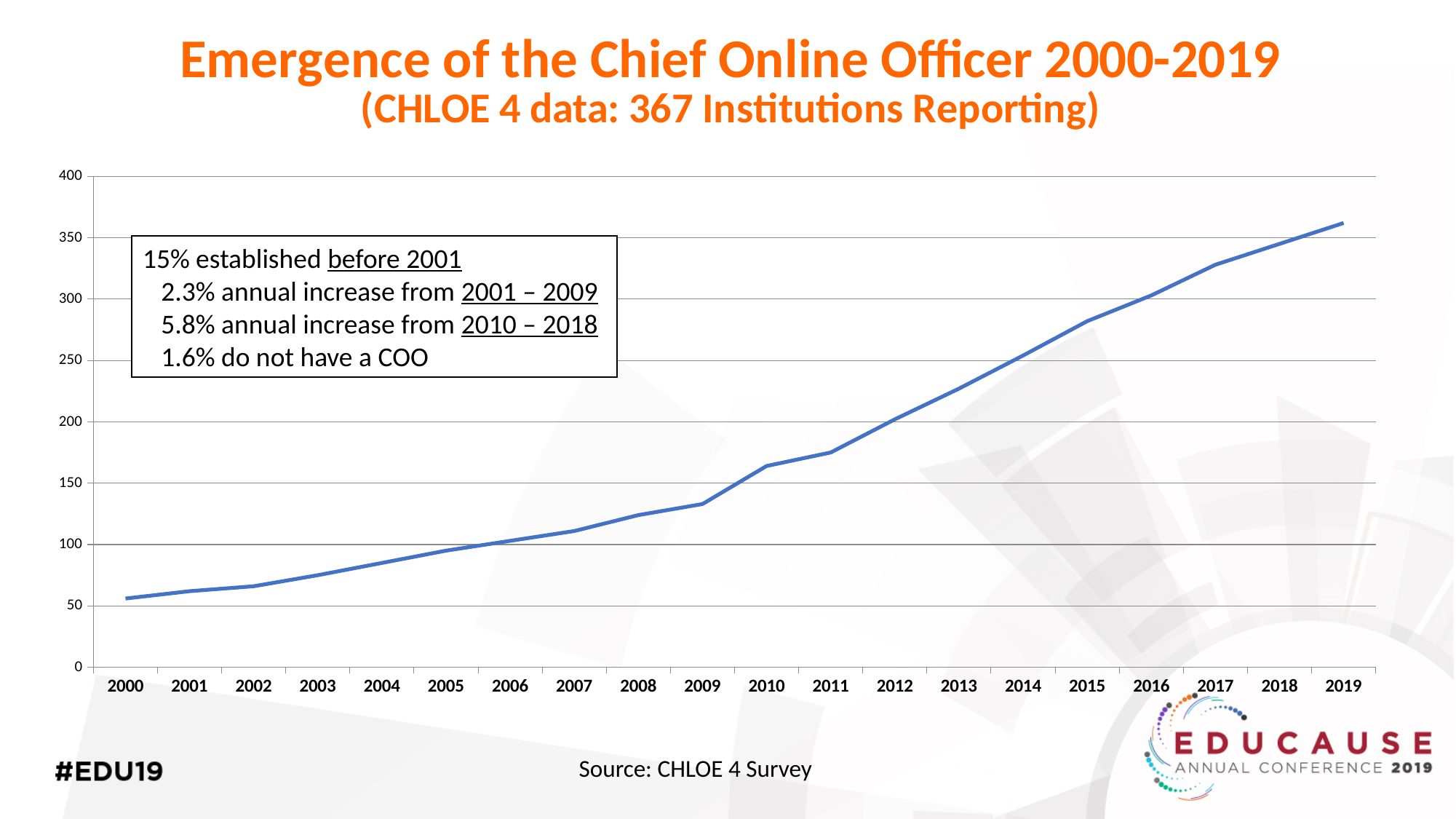
How many years are plotted along the x axis of the chart? 20 Which year has the larger value, 2009 or 2013? 2013 Is the value for 2010 greater or less than 150? greater Which year has the lowest value in the chart? 2000 Is the value for 2019 greater or less than 350? greater Which year has the highest value in the chart? 2019 Do the values in the chart rise or fall from 2000 to 2019? rise What kind of chart is shown on the slide? line chart Is the value for 2000 greater or less than 100? less What is the title of the chart on the slide? Emergence of the Chief Online Officer 2000-2019